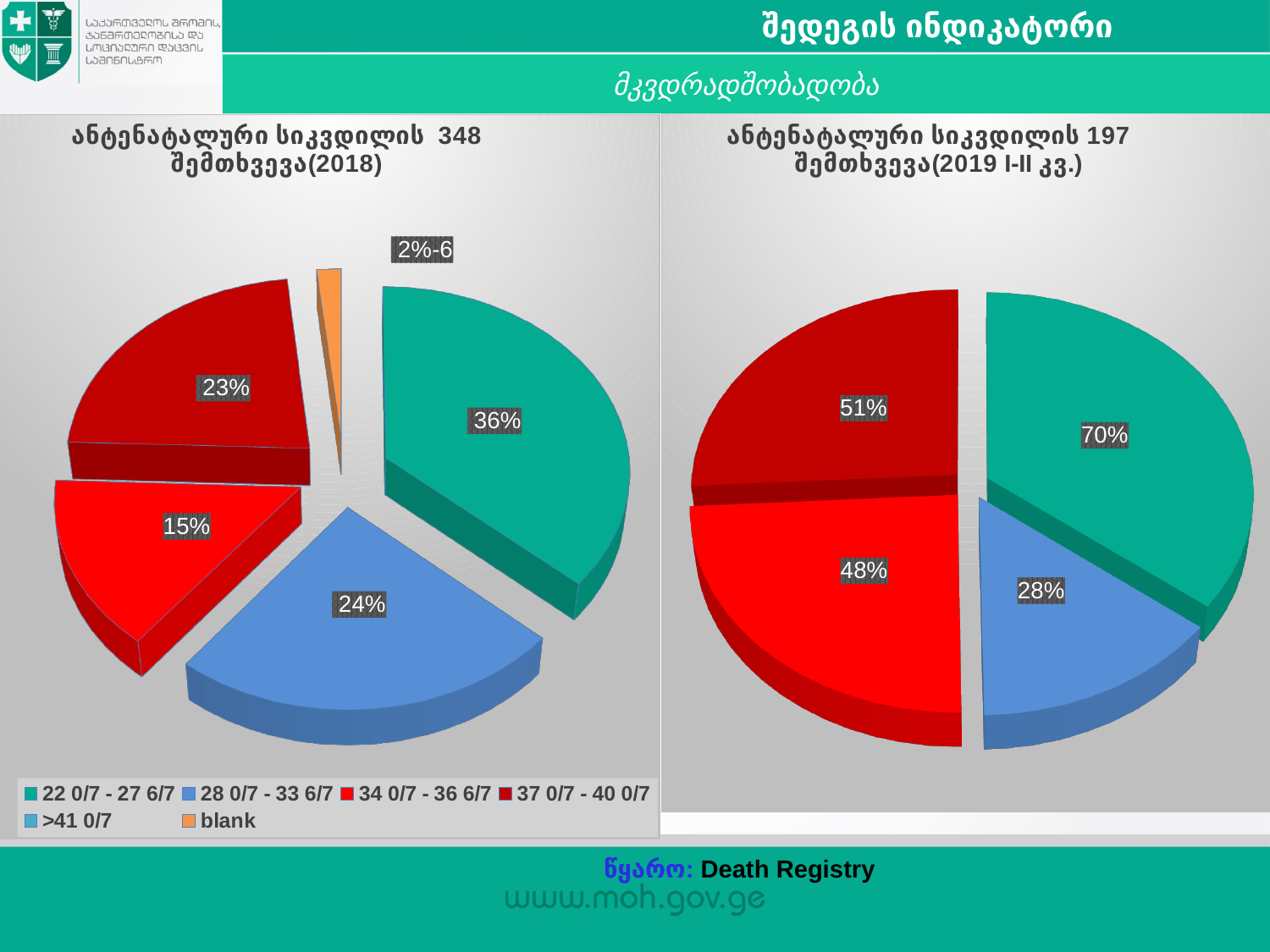
How many entries does the legend of the left pie chart list? 6 On the left pie chart, what percentage is shown for the 22 0/7 - 27 6/7 slice? 36% On the left pie chart, what percentage is shown for the 34 0/7 - 36 6/7 slice? 15% On the right pie chart, what percentage is shown on the blue slice? 28% What type of chart is used on the right side of the slide? Pie chart On the left pie chart, what is the difference between the 22 0/7 - 27 6/7 slice and the 28 0/7 - 33 6/7 slice? 12% On the left pie chart, what percentage is shown for the 28 0/7 - 33 6/7 slice? 24% On the left pie chart, what percentage is shown for the 37 0/7 - 40 0/7 slice? 23% On the left pie chart, which is larger: the 37 0/7 - 40 0/7 slice or the 34 0/7 - 36 6/7 slice? 37 0/7 - 40 0/7 On the right pie chart, what percentage is shown on the dark red slice? 51% On the left pie chart, which category has the largest slice? 22 0/7 - 27 6/7 On the right pie chart, what percentage is shown on the green slice? 70%